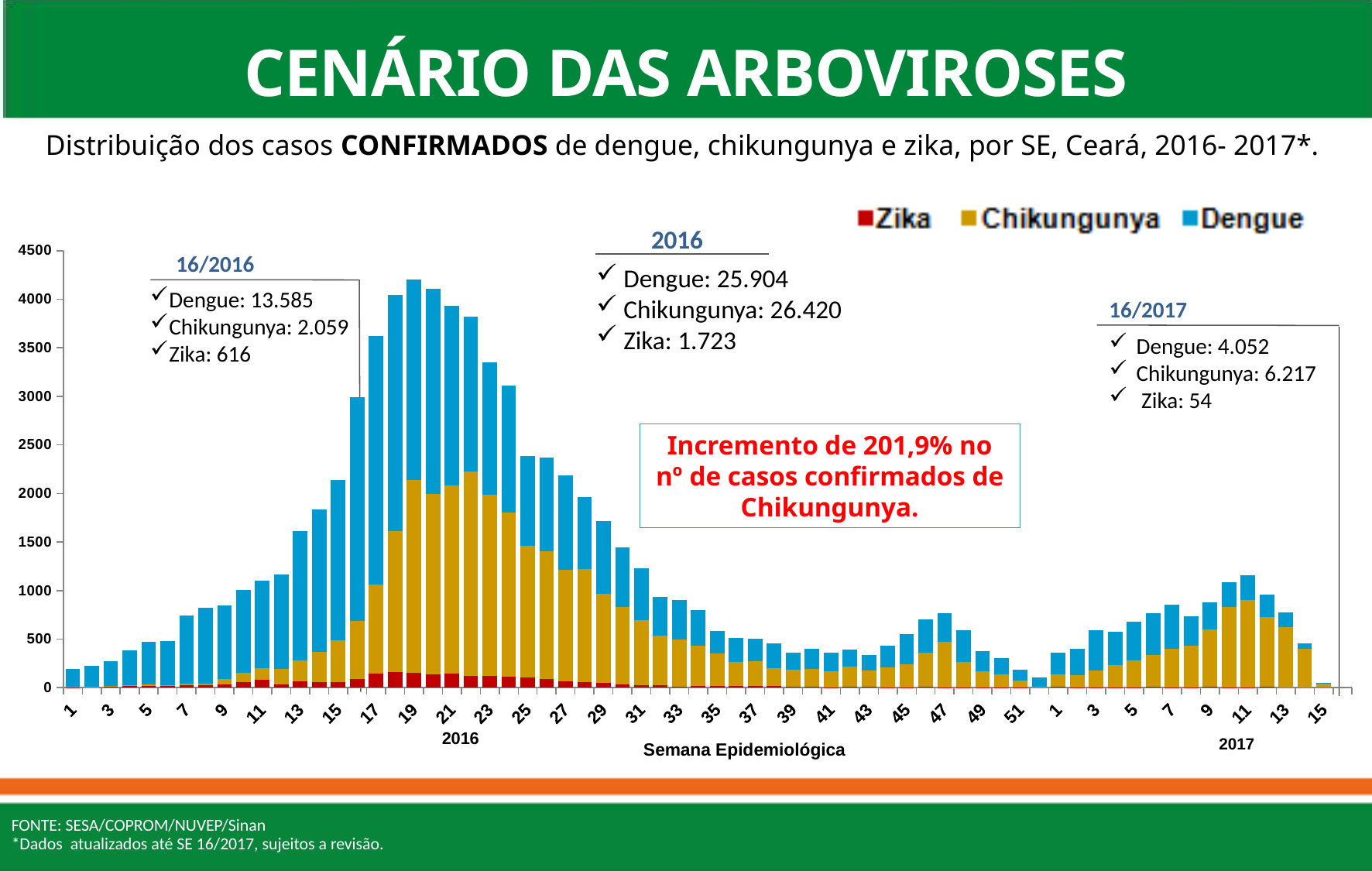
What is the difference between the 2016 Chikungunya total (26.420) and the 2016 Dengue total (25.904)? 516 Is the total value of the bar for week 15 of 2017 greater or less than 500? less What is the title of the x axis? Semana Epidemiológica What kind of chart is shown on the slide? bar chart Is the total value of the bar for week 19 of 2016 greater or less than 4000? greater Which series is shown in blue in the legend? Dengue According to the 2016 box, how many confirmed Chikungunya cases were there in 2016? 26.420 According to the 16/2017 box, how many confirmed Zika cases were there up to week 16 of 2017? 54 In the 2016 totals, which was larger: Dengue or Chikungunya? Chikungunya How many series does the legend list? 3 According to the 2016 box, how many confirmed Dengue cases were there in 2016? 25.904 Do the bar totals rise or fall from week 19 to week 31 of 2016? fall